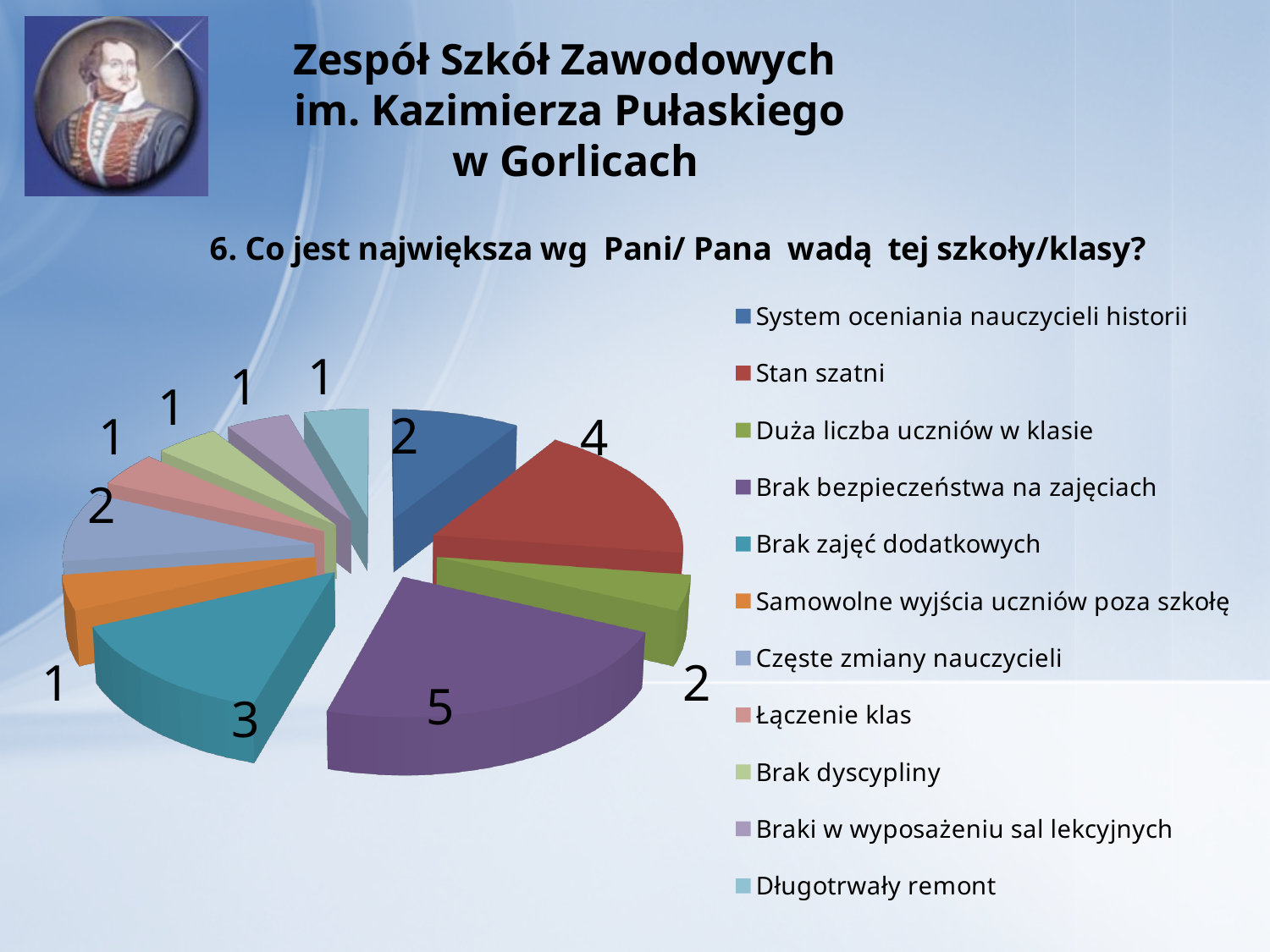
Which is larger, the value for Brak zajęć dodatkowych or the value for Częste zmiany nauczycieli? Brak zajęć dodatkowych What is the value for Samowolne wyjścia uczniów poza szkołę? 1 How many categories does the pie chart have? 11 What is the difference between the values for Stan szatni and Brak zajęć dodatkowych? 1 What is the question text shown above the pie chart? 6. Co jest największa wg Pani/ Pana wadą tej szkoły/klasy? Which category has the largest slice in the pie chart? Brak bezpieczeństwa na zajęciach What kind of chart is shown on the slide? pie chart What is the difference between the values for Brak bezpieczeństwa na zajęciach and Stan szatni? 1 What is the value for Stan szatni? 4 What is the value for System oceniania nauczycieli historii? 2 What is the value for Brak zajęć dodatkowych? 3